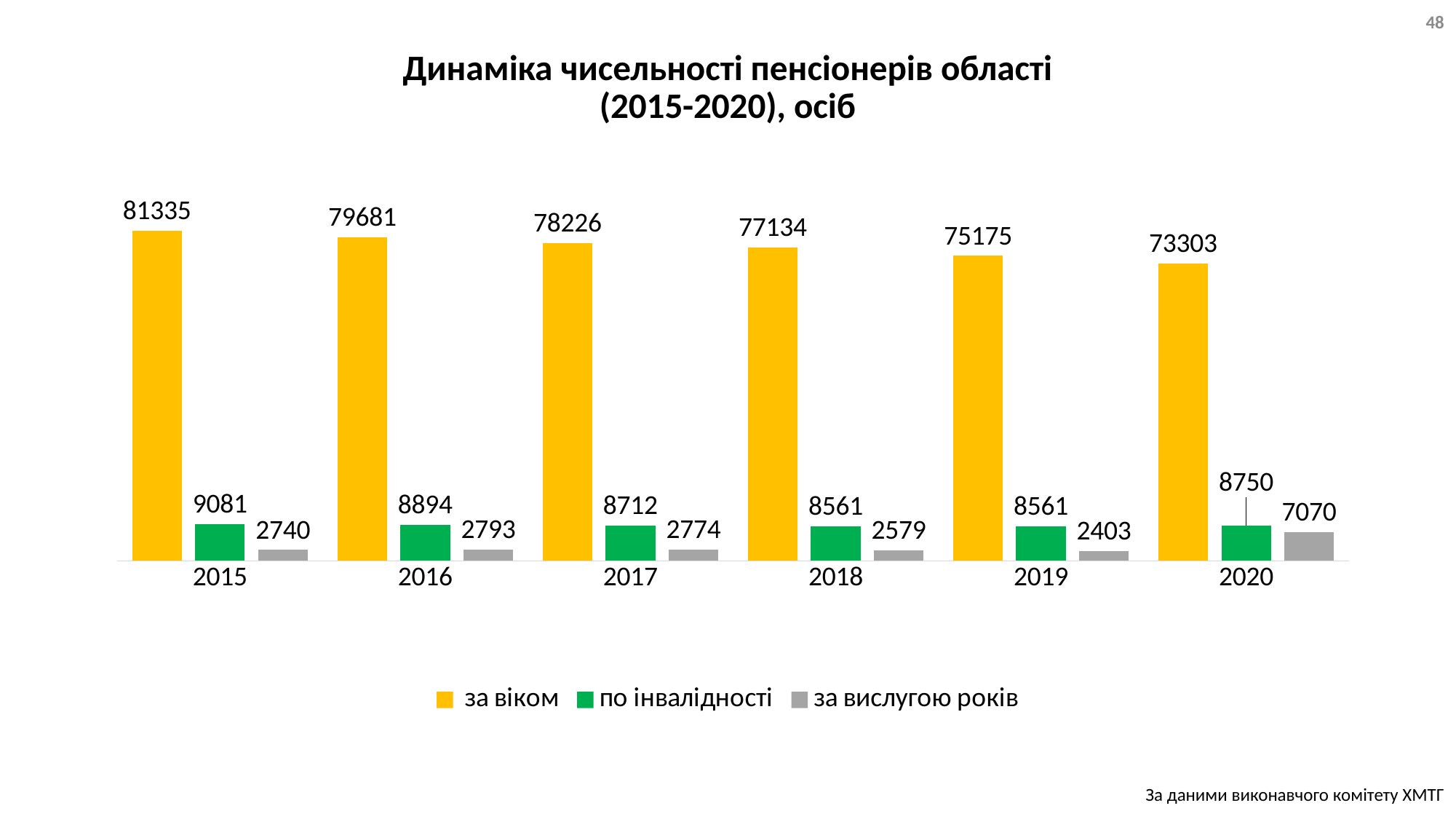
How many years are shown on the x axis? 6 How does the "за віком" value change from 2015 to 2020? It falls What is the value for "за вислугою років" in 2018? 2579 How many series does the legend list? 3 What is the value for "по інвалідності" in 2020? 8750 In which year is the "за віком" value lowest? 2020 Which is larger: the "по інвалідності" value in 2016 or in 2019? 2016 What is the value for "за віком" in 2015? 81335 What kind of chart is shown on the slide? Bar chart Which colour represents the "по інвалідності" series? Green What is the difference between the "за віком" values in 2015 and 2020? 8032 In which year is the "за вислугою років" value highest? 2020